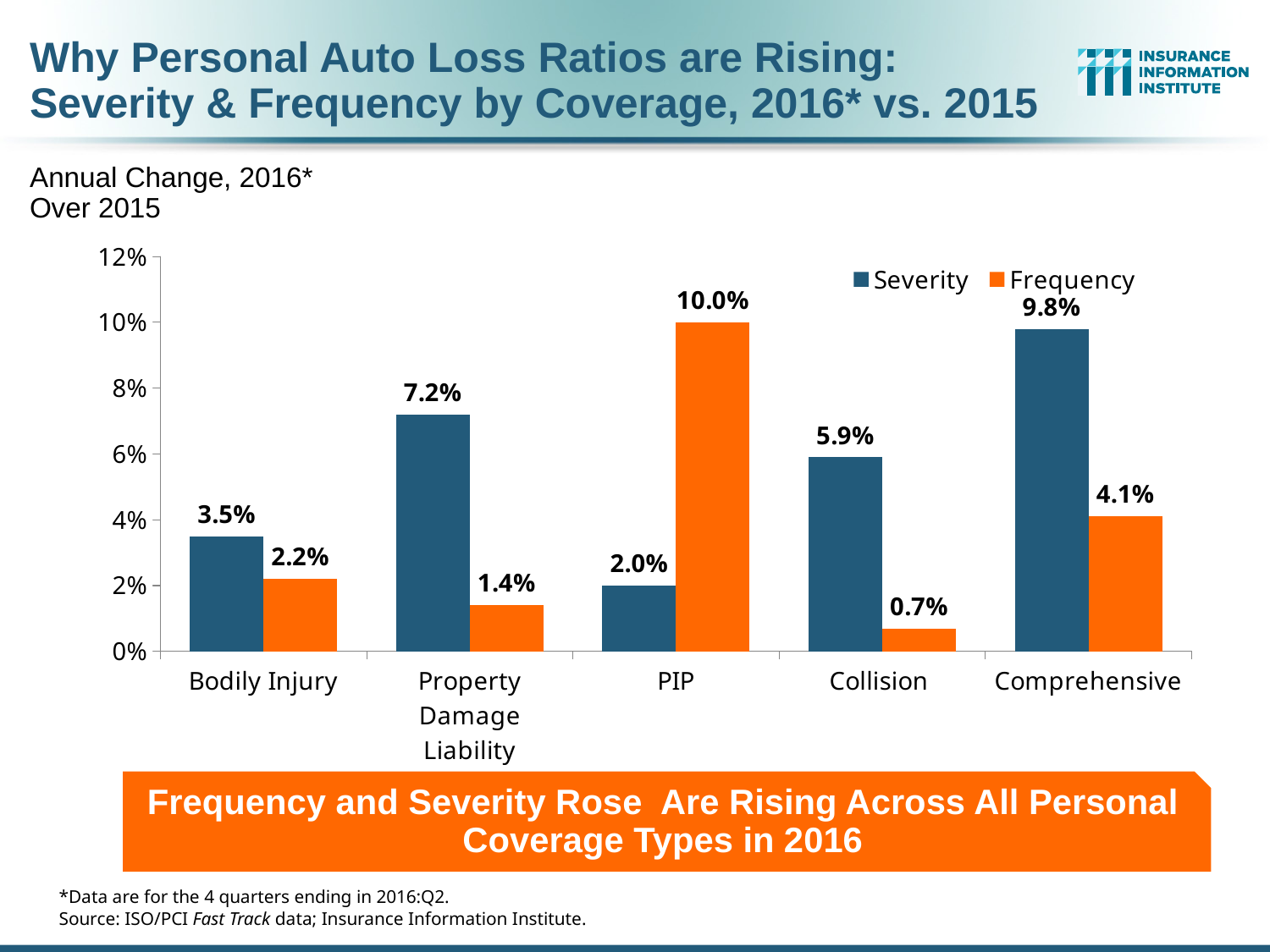
What is the Frequency value for Collision? 0.7% What kind of chart is shown on the slide? Bar chart How many coverage types are shown on the x axis? 5 How many series does the legend list? 2 What is the Severity value for Comprehensive? 9.8% What is the Frequency value for PIP? 10.0% Is the Severity value for Collision greater or less than 4%? greater What is the Severity value for Property Damage Liability? 7.2% Which coverage type has the lowest Frequency value? Collision Which is larger for Bodily Injury, Severity or Frequency? Severity Which coverage type has the highest Severity value? Comprehensive What is the difference between the Frequency and Severity values for PIP? 8.0%